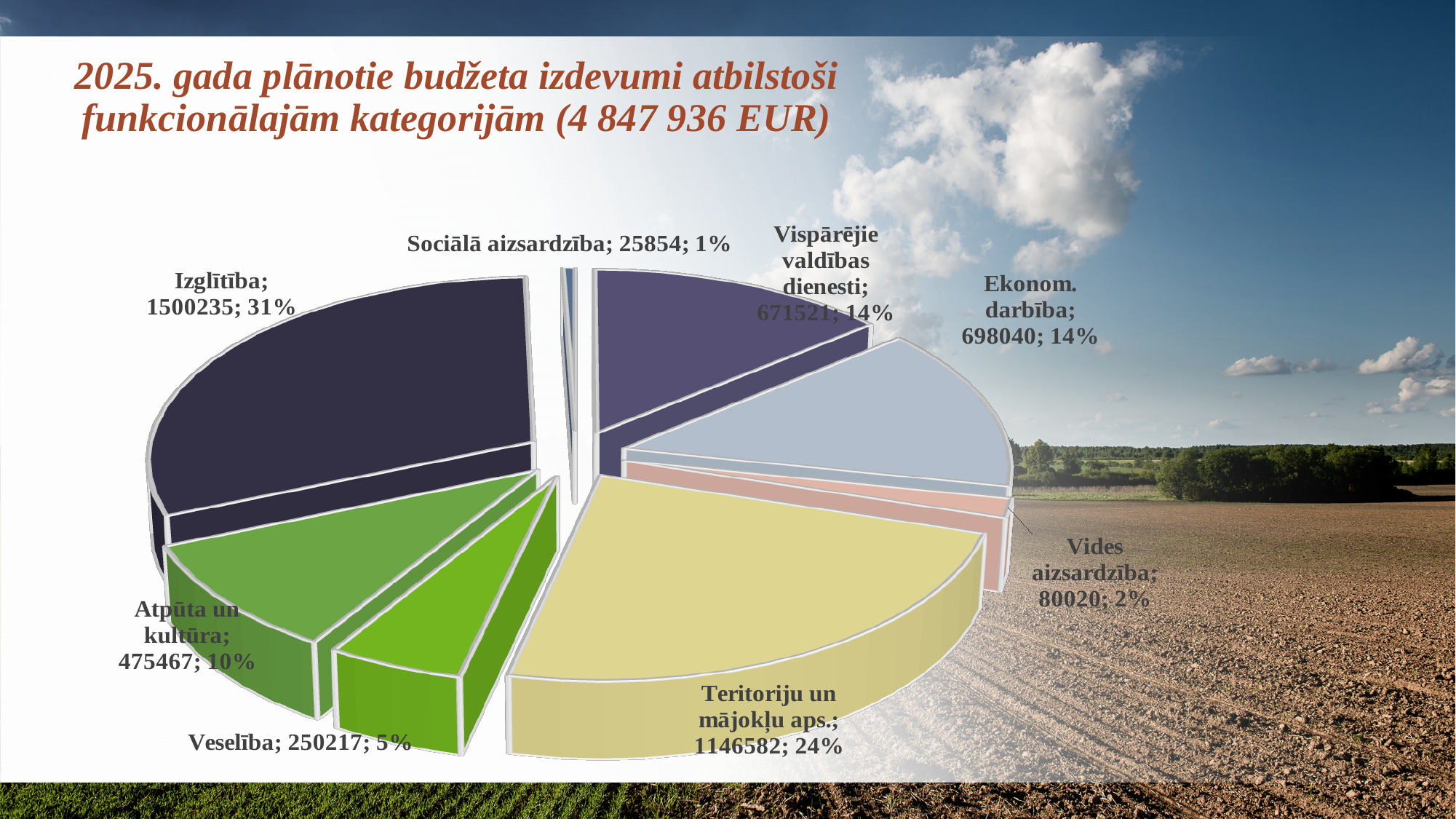
Which category has the largest share of the pie? Izglītība Which is larger, the value for Ekonom. darbība or the value for Vispārējie valdības dienesti? Ekonom. darbība What share of the pie does Teritoriju un mājokļu aps. represent? 24% How many categories does the pie chart show? 8 What is the value for Izglītība? 1500235 What is the difference between the values for Izglītība and Teritoriju un mājokļu aps.? 353653 What is the value for Vides aizsardzība? 80020 What total amount in EUR is stated in the chart title? 4 847 936 EUR What kind of chart is shown on the slide? Pie chart Which category has the smallest share of the pie? Sociālā aizsardzība What share of the pie does Atpūta un kultūra represent? 10% What is the value for Veselība? 250217